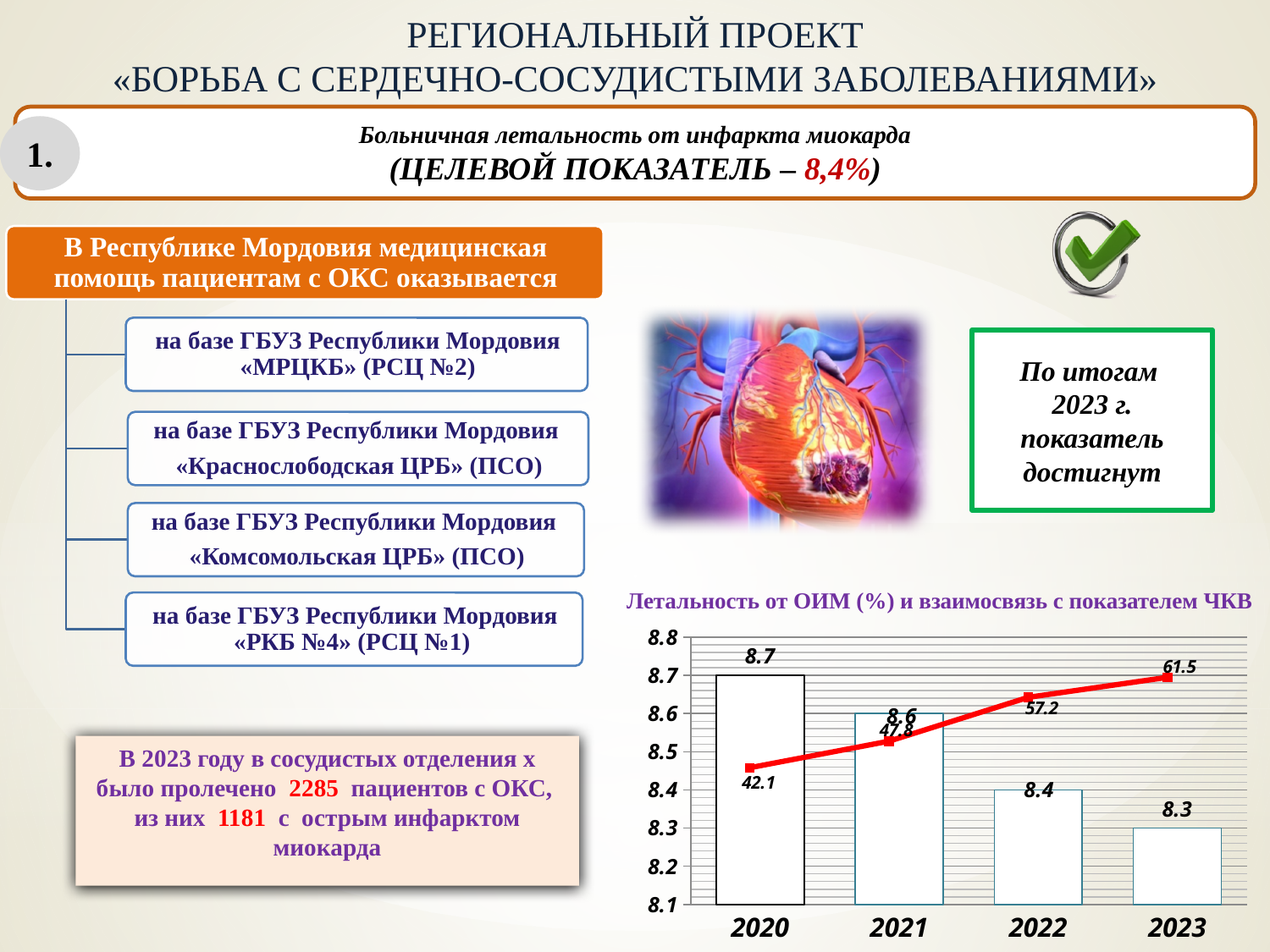
Do the bar values rise or fall from 2020 to 2023? fall What is the difference between the bar values for 2020 and 2023? 0.4 What is the line (ЧКВ) value for 2020 in the chart? 42.1 How many years are shown on the x axis of the chart? 4 Which is larger, the bar value for 2021 or for 2022? 2021 What is the line (ЧКВ) value for 2022 in the chart? 57.2 Which year has the highest bar value in the chart? 2020 Which year has the lowest bar value in the chart? 2023 What is the difference between the line values for 2023 and 2020? 19.4 What is the bar value for 2020 in the chart 'Летальность от ОИМ (%) и взаимосвязь с показателем ЧКВ'? 8.7 What is the title of the chart on the slide? Летальность от ОИМ (%) и взаимосвязь с показателем ЧКВ What is the bar value for 2023 in the chart? 8.3